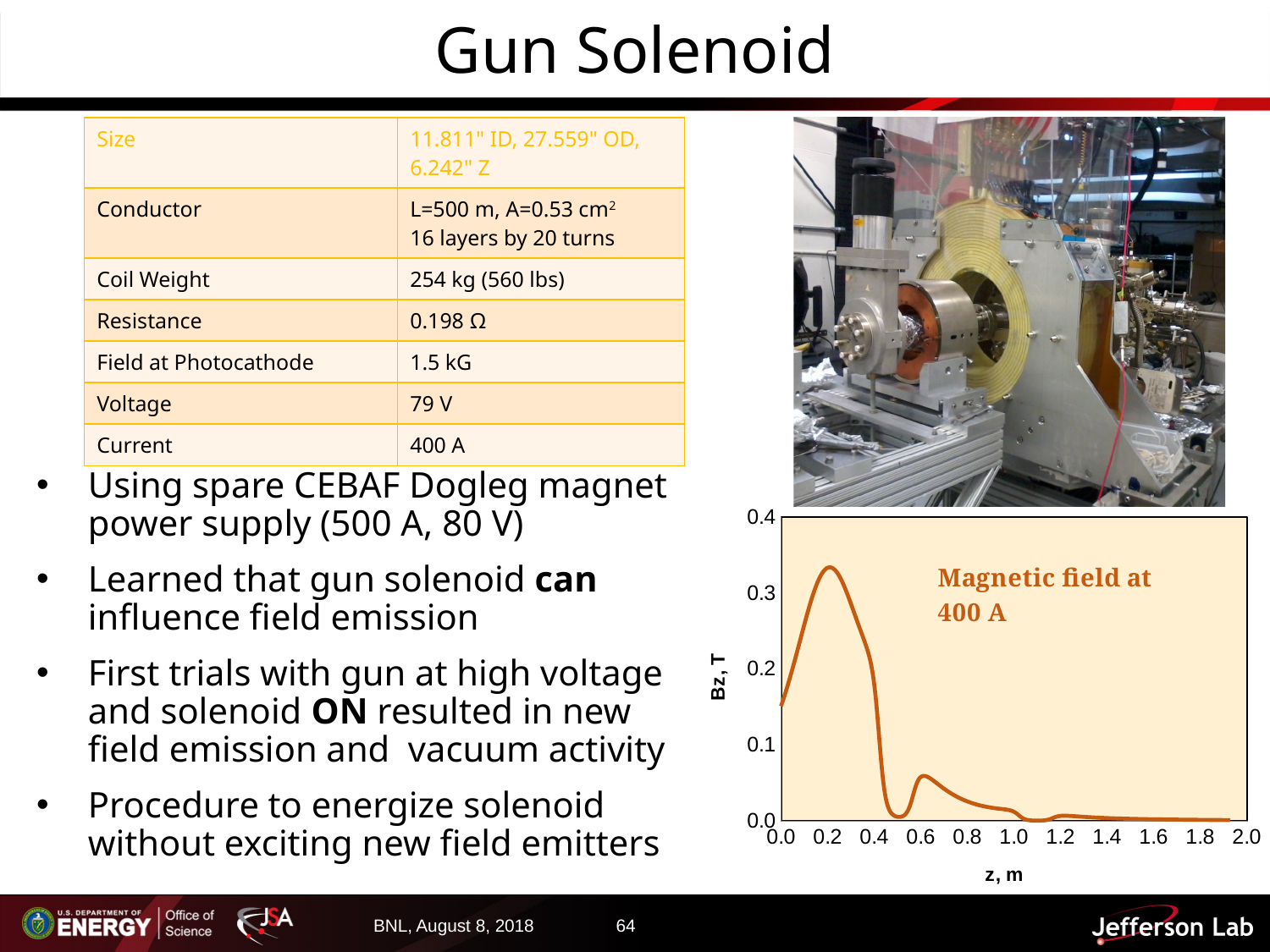
Is the value of Bz at z = 0.6 m greater or less than 0.1? less Does Bz rise or fall as z increases from 0.0 m to 0.2 m? rise Is the peak value of Bz on the chart greater or less than 0.4? less What kind of chart is shown on the slide? line chart What is the label of the x axis of the chart? z, m What is the label of the y axis of the chart? Bz, T Does Bz rise or fall as z increases from 0.4 m to 0.5 m? fall What is the largest value shown on the x axis of the chart? 2.0 Is the value of Bz at z = 1.0 m greater or less than 0.1? less